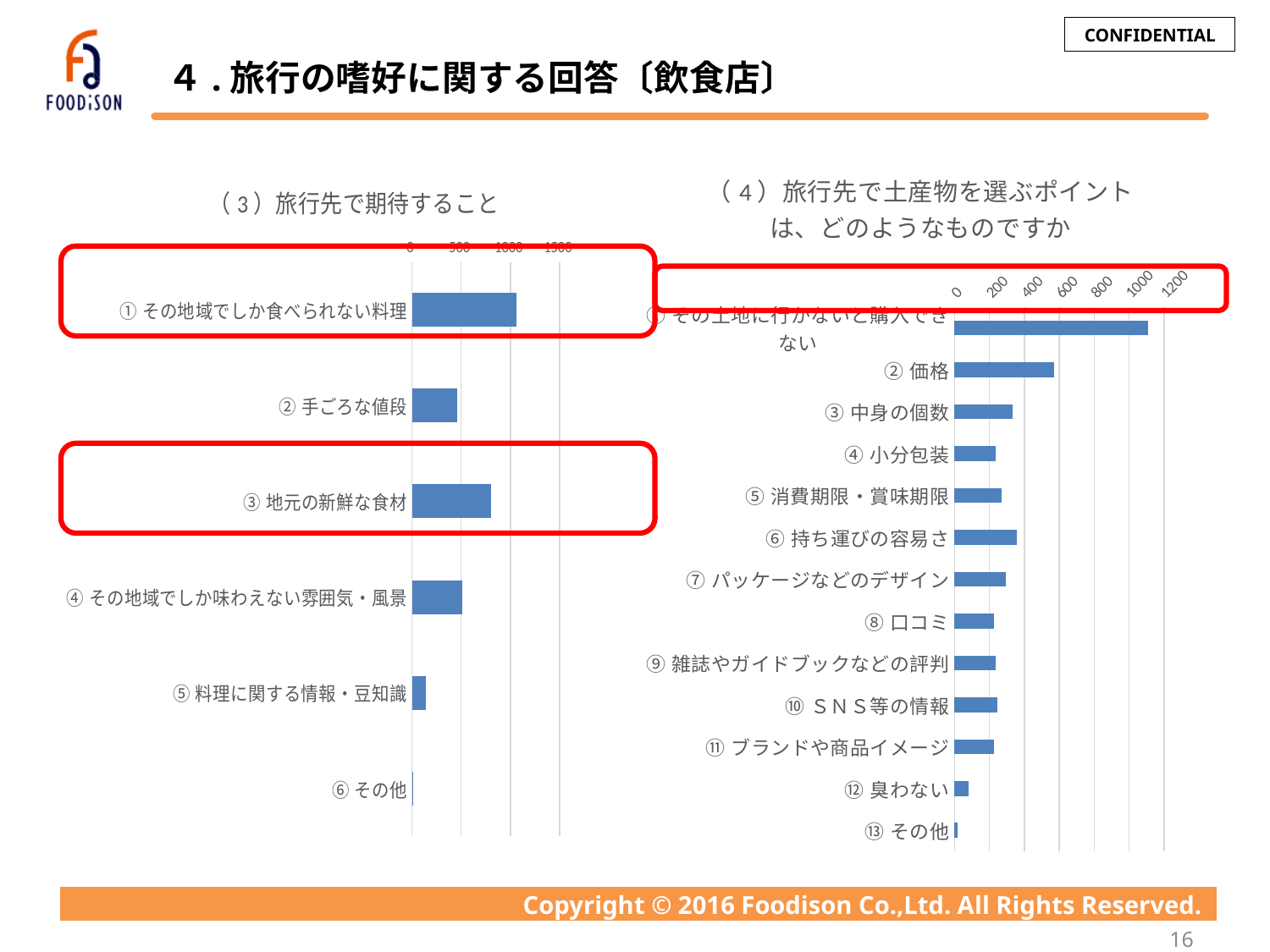
In the left chart （3）旅行先で期待すること, which is larger: ② 手ごろな値段 or ③ 地元の新鮮な食材? ③ 地元の新鮮な食材 In the left chart （3）旅行先で期待すること, is the value for ① その地域でしか食べられない料理 greater or less than 1000? greater In the right chart （4）旅行先で土産物を選ぶポイントは、どのようなものですか, how many categories are shown? 13 What kind of chart is the left chart titled （3）旅行先で期待すること? bar chart In the right chart （4）旅行先で土産物を選ぶポイント, is the value for ⑫ 臭わない greater or less than 200? less In the left chart （3）旅行先で期待すること, how many categories are shown? 6 In the right chart （4）旅行先で土産物を選ぶポイント, which category has the lowest value? ⑬ その他 In the left chart （3）旅行先で期待すること, is the value for ③ 地元の新鮮な食材 greater or less than 1000? less In the left chart （3）旅行先で期待すること, which category has the lowest value? ⑥ その他 In the right chart （4）旅行先で土産物を選ぶポイント, which category has the highest value? ① その土地に行かないと購入できない In the left chart （3）旅行先で期待すること, which category has the highest value? ① その地域でしか食べられない料理